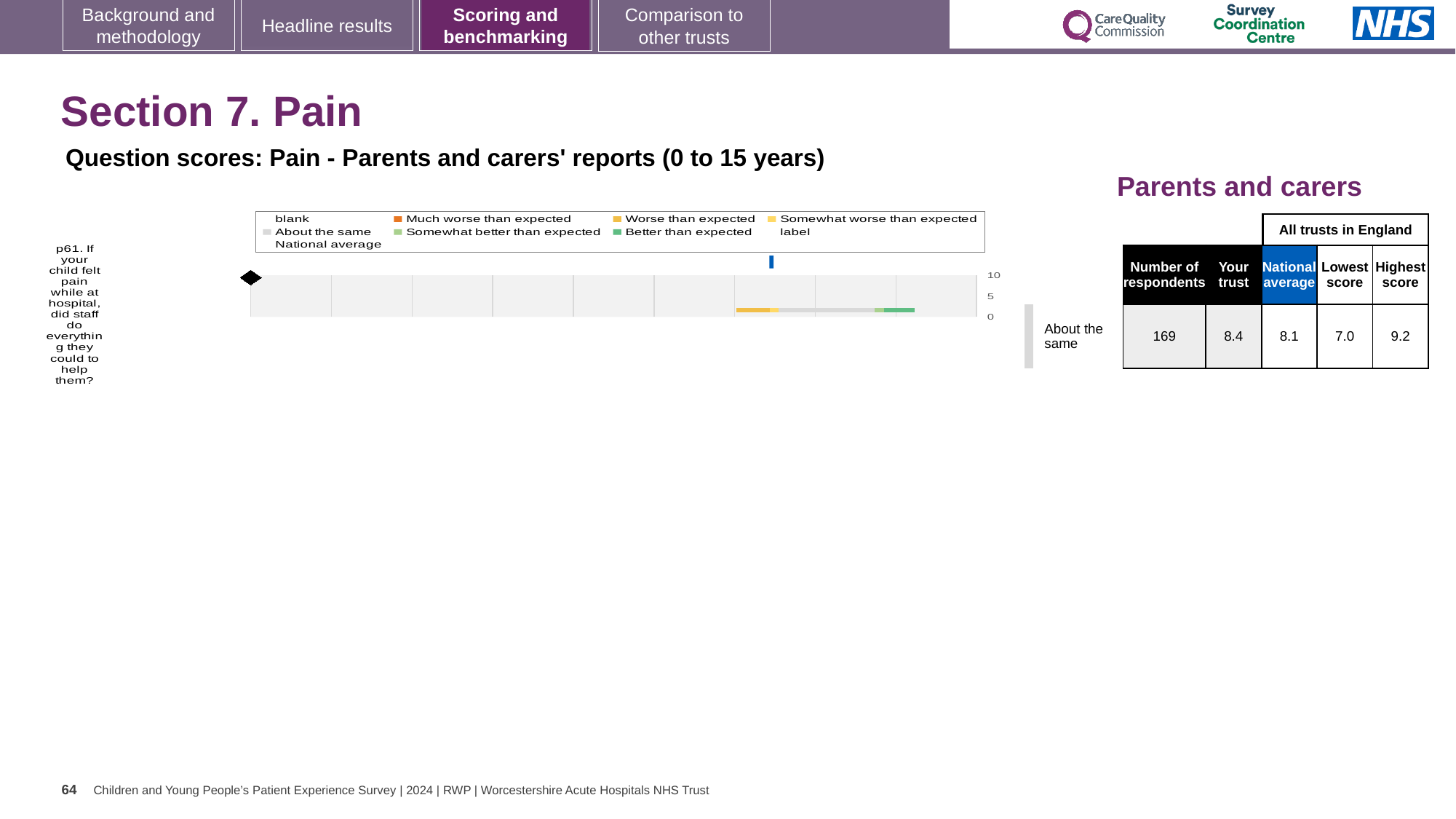
Which survey question is plotted in the chart? p61. If your child felt pain while at hospital, did staff do everything they could to help them? In the table on the right, what is the 'Your trust' score? 8.4 What is the highest tick value shown on the chart's axis? 10 How many entries does the chart's legend list? 9 In the table on the right, which is larger: the 'Your trust' score or the national average? Your trust In the table on the right, what is the national average score? 8.1 In the table on the right, what is the highest score among all trusts in England? 9.2 In the table on the right, what is the number of respondents for the 'About the same' row? 169 In the table on the right, what is the lowest score among all trusts in England? 7.0 In the table on the right, what is the difference between the highest score and the lowest score? 2.2 How many survey questions are plotted in the chart? 1 What kind of chart is shown on the slide? bar chart